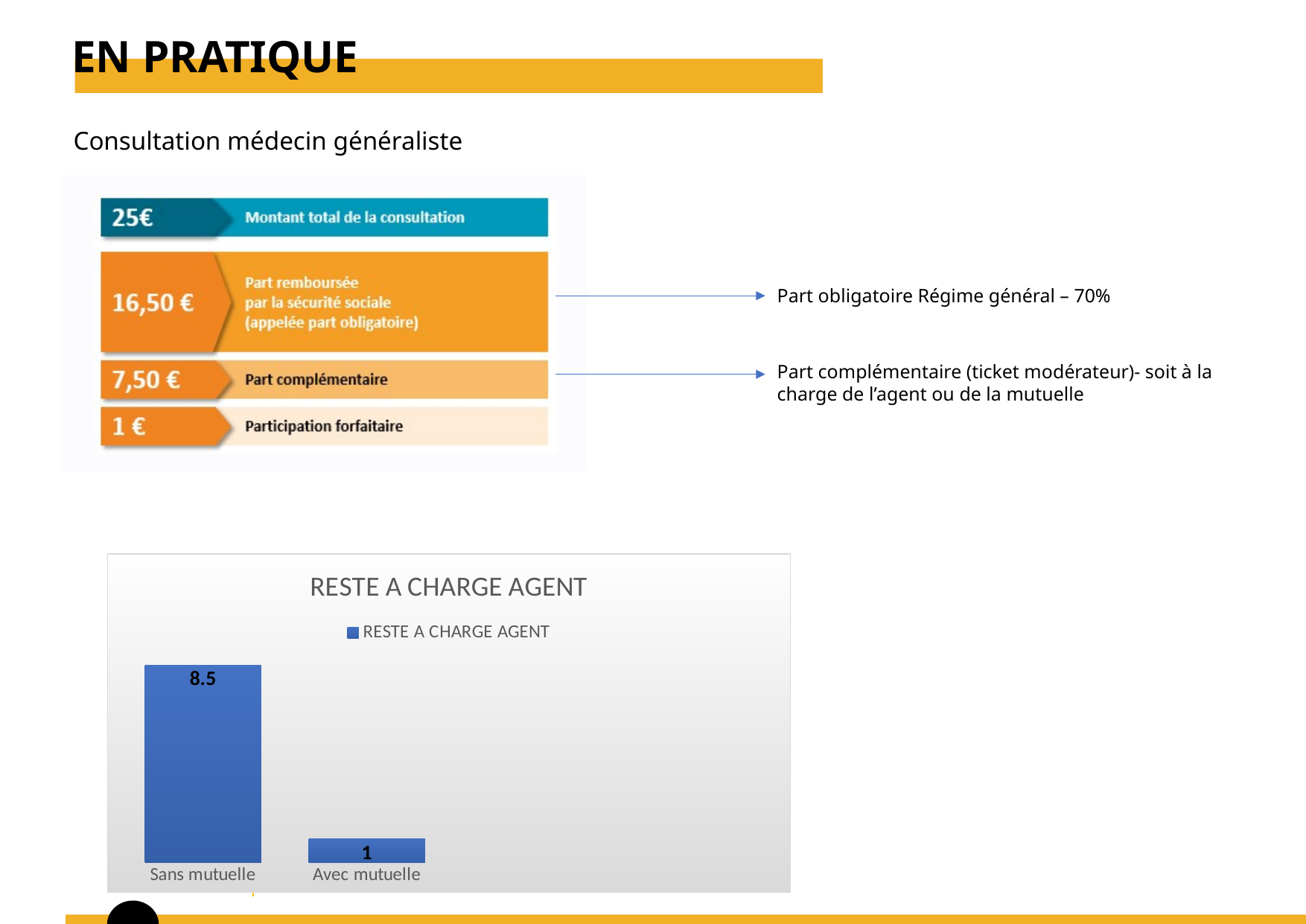
What is the legend entry in the RESTE A CHARGE AGENT chart? RESTE A CHARGE AGENT How many categories are shown in the RESTE A CHARGE AGENT chart? 2 Do the values in the RESTE A CHARGE AGENT chart rise or fall from left to right? Fall Which category has the lowest value in the RESTE A CHARGE AGENT chart? Avec mutuelle What is the value for Avec mutuelle in the RESTE A CHARGE AGENT chart? 1 What is the title of the chart at the bottom of the slide? RESTE A CHARGE AGENT What kind of chart is the RESTE A CHARGE AGENT chart? Bar chart In the RESTE A CHARGE AGENT chart, which is larger: Sans mutuelle or Avec mutuelle? Sans mutuelle What is the value for Sans mutuelle in the RESTE A CHARGE AGENT chart? 8.5 How many series does the legend of the RESTE A CHARGE AGENT chart list? 1 What is the difference between the Sans mutuelle and Avec mutuelle values in the RESTE A CHARGE AGENT chart? 7.5 Which category has the highest value in the RESTE A CHARGE AGENT chart? Sans mutuelle